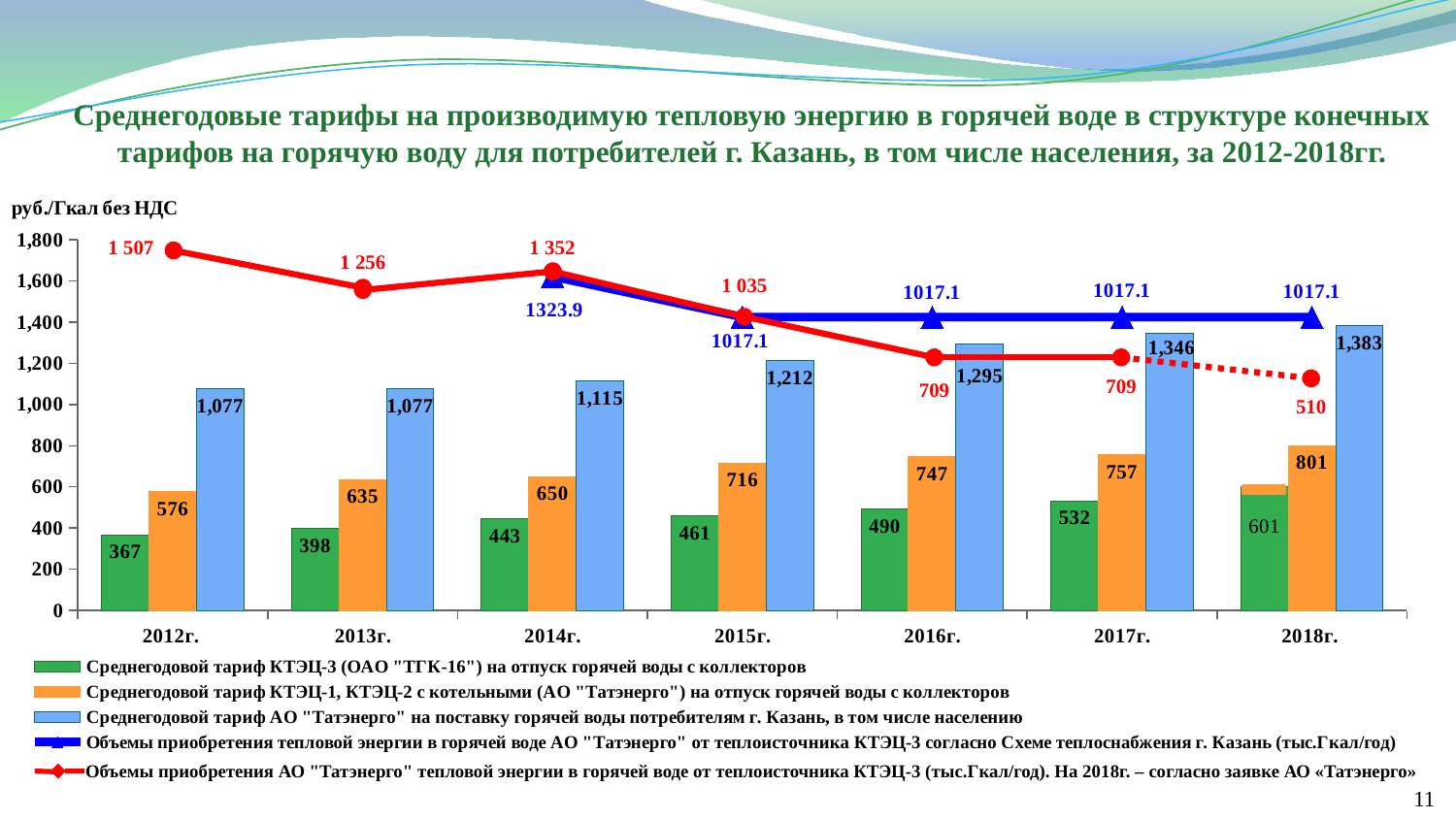
What value does the blue line with triangle markers show for 2014г.? 1323.9 What is the difference between the orange bar values for 2018г. and 2012г.? 225 In which year is the green bar (Среднегодовой тариф КТЭЦ-3) the lowest? 2012г. How many years are shown on the x axis? 7 How many series does the legend list? 5 What is the value of the orange bar (Среднегодовой тариф КТЭЦ-1, КТЭЦ-2 с котельными) for 2018г.? 801 Which is larger: the green bar for 2017г. or the orange bar for 2012г.? The orange bar for 2012г. (576) In which year is the light blue bar (Среднегодовой тариф АО "Татэнерго") the highest? 2018г. What value does the red line show for 2012г.? 1 507 What is the value of the green bar (Среднегодовой тариф КТЭЦ-3 (ОАО "ТГК-16")) for 2012г.? 367 What is the value of the light blue bar (Среднегодовой тариф АО "Татэнерго" на поставку горячей воды) for 2015г.? 1,212 Do the green bar values rise or fall from 2012г. to 2018г.? Rise